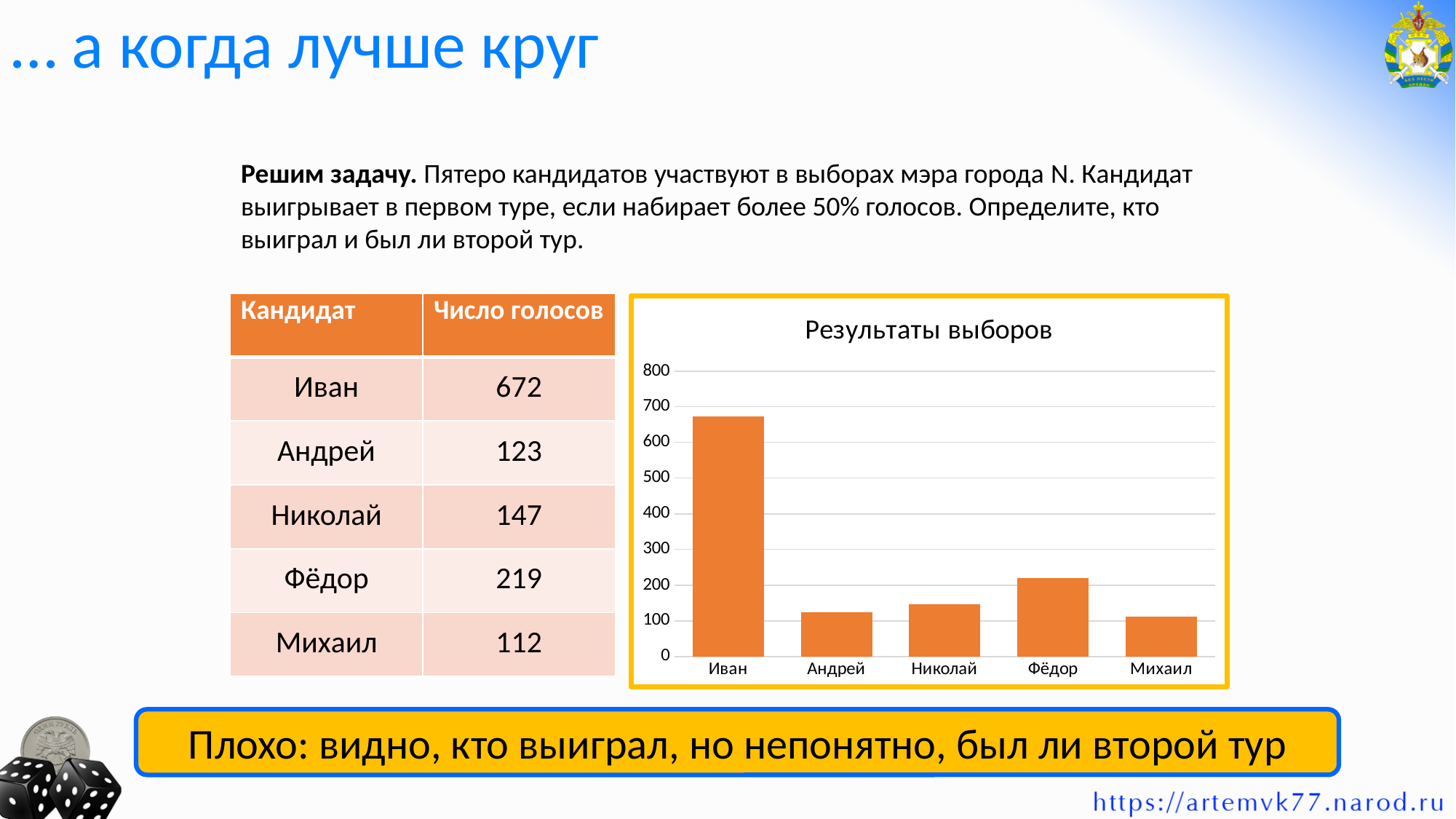
Is the value for Андрей greater or less than 100? greater Is the value for Фёдор greater or less than 300? less How many votes does the slide give for Фёдор? 219 What is the difference between the votes for Иван and the votes for Фёдор, as printed on the slide? 453 What is the highest value shown on the chart's vertical axis? 800 Which is larger in the chart, the value for Николай or the value for Андрей? Николай Is the value for Иван greater or less than 600? greater What type of chart is shown under the title "Результаты выборов"? bar chart Which candidate has the highest bar in the chart? Иван What is the title of the chart? Результаты выборов Which candidate has the lowest bar in the chart? Михаил How many candidates are shown on the x axis of the chart? 5